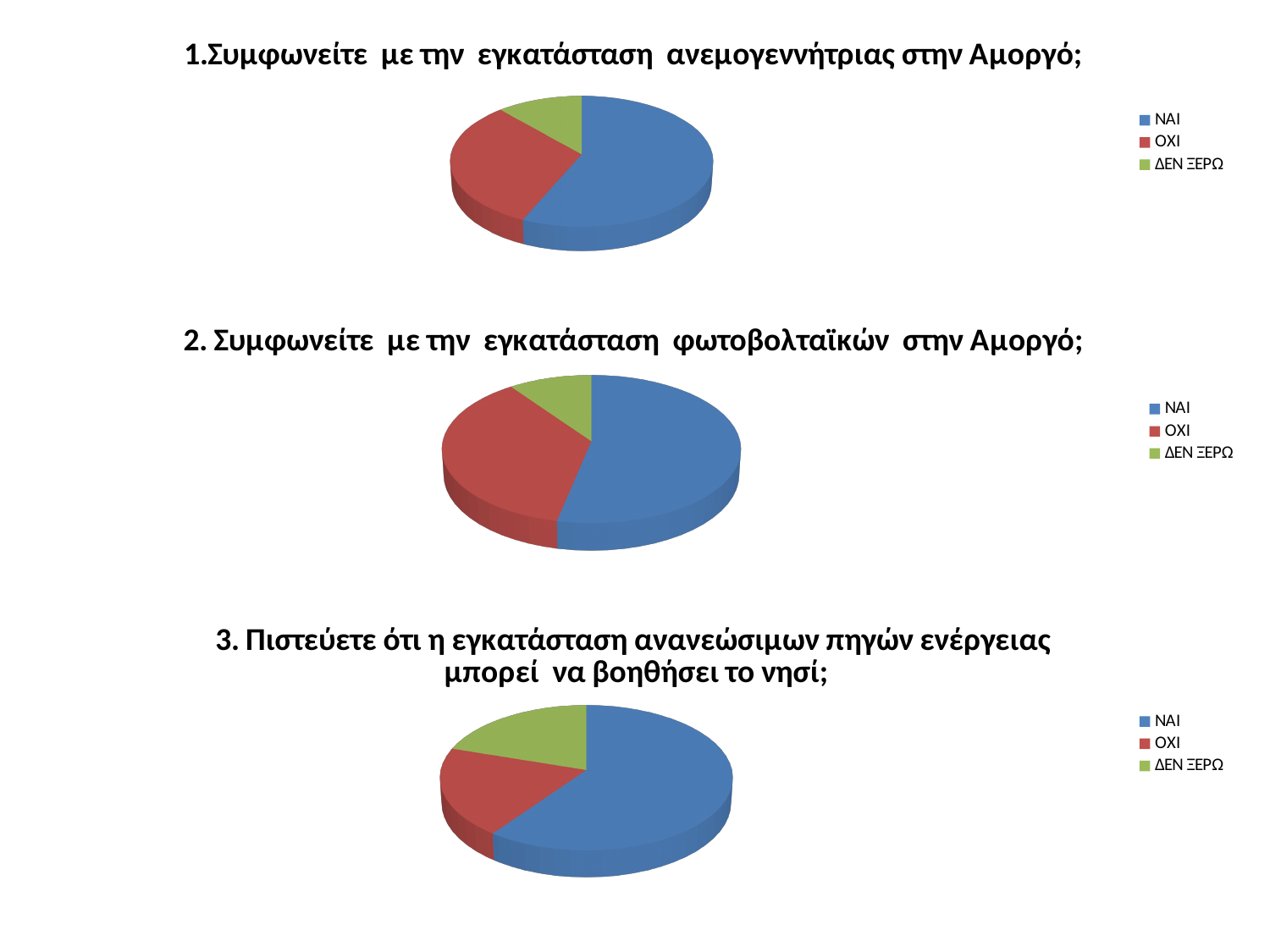
In the middle chart (question 2), which category has the smallest slice? ΔΕΝ ΞΕΡΩ In the top chart (question 1), how many categories does the legend list? 3 In the middle chart (question 2), which slice is larger, ΟΧΙ or ΔΕΝ ΞΕΡΩ? ΟΧΙ In the top chart (question 1), which category has the largest slice? ΝΑΙ In the bottom chart (question 3), which category has the largest slice? ΝΑΙ In the bottom chart (question 3), which slice is larger, ΝΑΙ or ΟΧΙ? ΝΑΙ In the top chart (question 1), which category has the smallest slice? ΔΕΝ ΞΕΡΩ In the top chart (question 1), what colour represents ΟΧΙ? Red How many charts are on the slide? 3 What kind of chart is used for question 1 (top chart)? Pie chart In the middle chart (question 2), which category has the largest slice? ΝΑΙ What are the three legend entries shown for the bottom chart (question 3)? ΝΑΙ, ΟΧΙ, ΔΕΝ ΞΕΡΩ